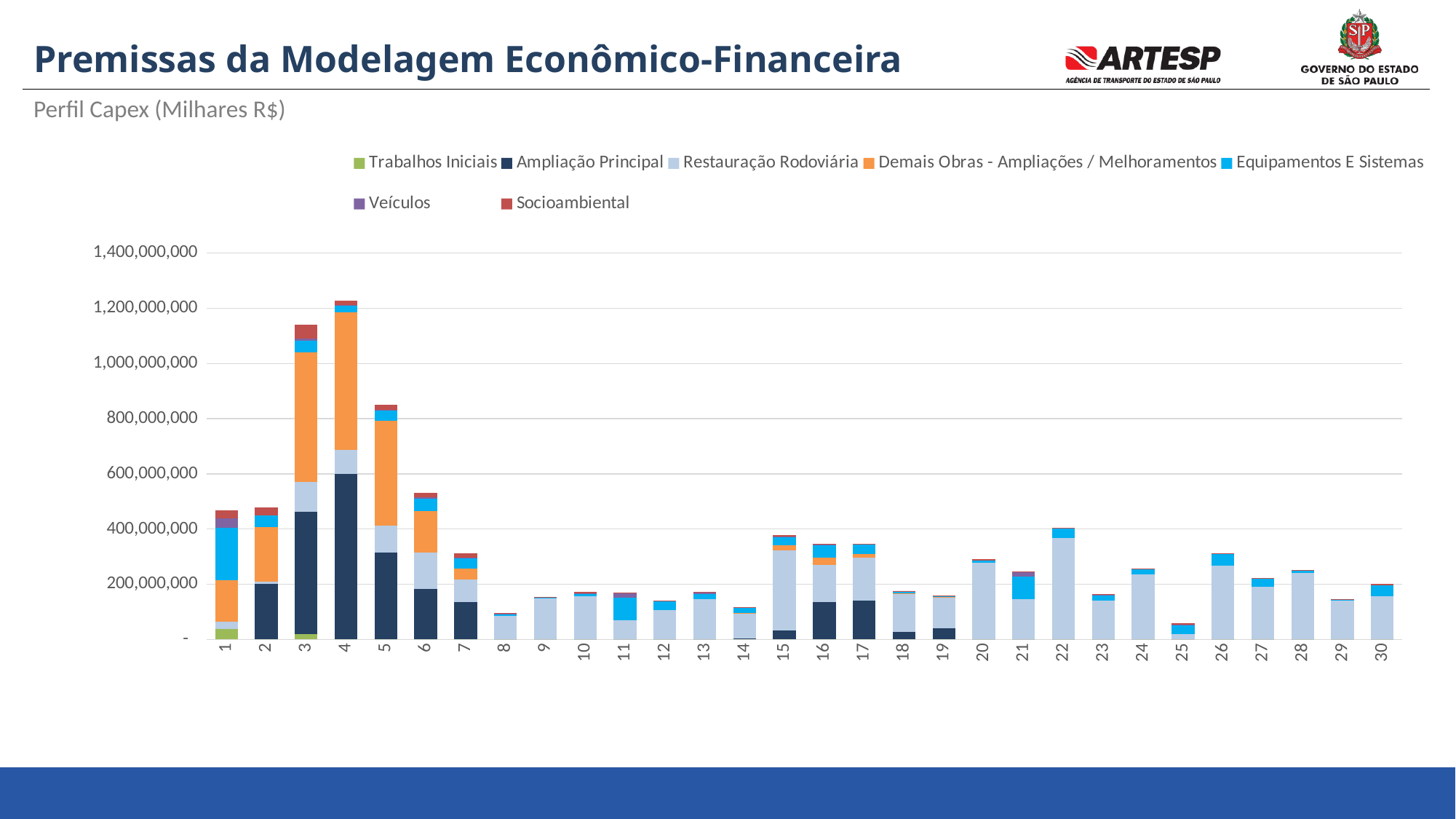
Is the total value for year 5 greater or less than 800,000,000? greater Which has the larger total bar, year 3 or year 5? Year 3 Do the total bar values rise or fall from year 4 to year 8? Fall How many categories (years) are shown along the x axis of the chart? 30 Is the total value for year 1 greater or less than 400,000,000? greater Is the total value for year 3 greater or less than 1,000,000,000? greater Which year has the highest total stacked bar in the chart? 4 What kind of chart is shown on the slide? Stacked bar chart Which year has the lowest total stacked bar in the chart? 25 What is the subtitle shown above the chart? Perfil Capex (Milhares R$) How many series does the chart's legend list? 7